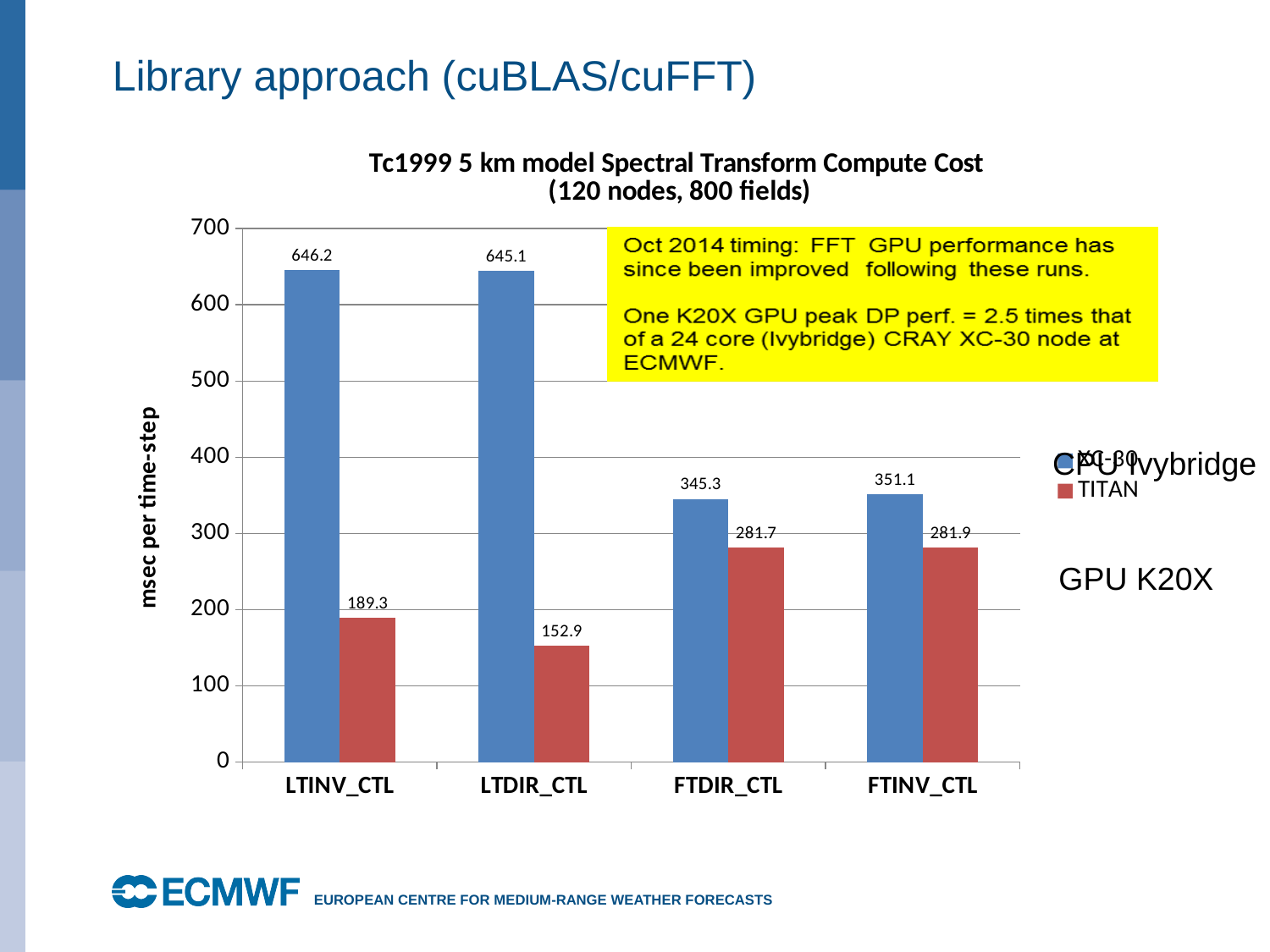
Is the TITAN value for LTINV_CTL greater or less than 200? less How many categories are shown on the x axis? 4 What is the difference between the blue bar and the TITAN bar for LTINV_CTL? 456.9 Which category has the lowest TITAN value? LTDIR_CTL For LTDIR_CTL, which is larger: the blue bar or the TITAN bar? the blue bar What is the difference between the blue bar and the TITAN bar for FTDIR_CTL? 63.6 What is the label of the y axis? msec per time-step What is the TITAN value for FTINV_CTL? 281.9 What is the TITAN value for LTDIR_CTL? 152.9 What is the value of the blue bar for FTDIR_CTL? 345.3 What kind of chart is shown on the slide? bar chart What is the value of the blue bar for LTINV_CTL? 646.2